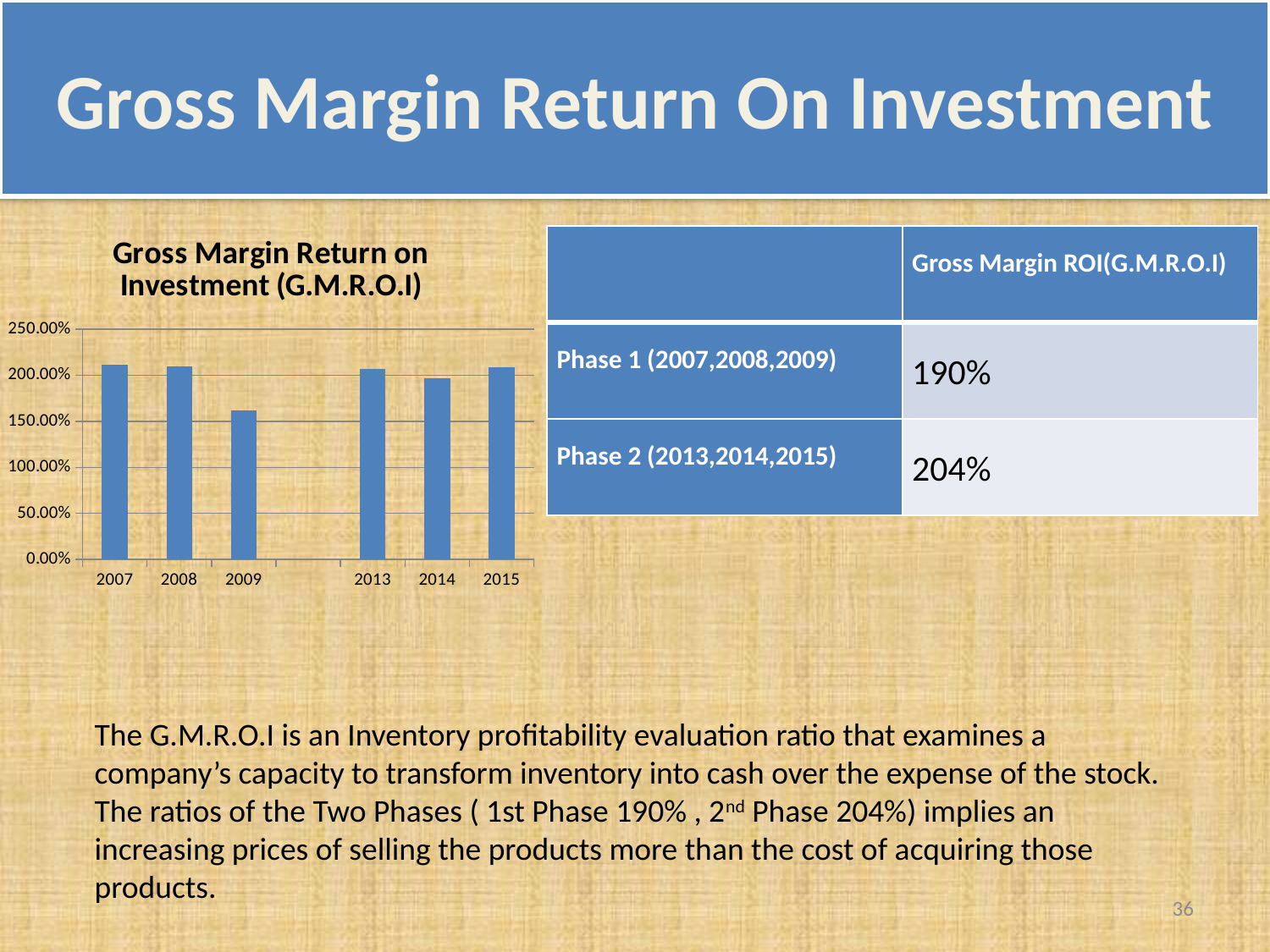
Which year has the lowest Gross Margin Return on Investment in the chart? 2009 Which is larger, the value for 2009 or the value for 2013? 2013 Is the value for 2008 greater or less than 200.00%? greater Is the value for 2014 greater or less than 150.00%? greater Is the value for 2009 greater or less than 150.00%? greater Which is larger, the value for 2007 or the value for 2009? 2007 From 2007 to 2009, do the values rise or fall? fall What is the title of the chart? Gross Margin Return on Investment (G.M.R.O.I) What kind of chart is shown on the slide? bar chart How many years are plotted in the chart? 6